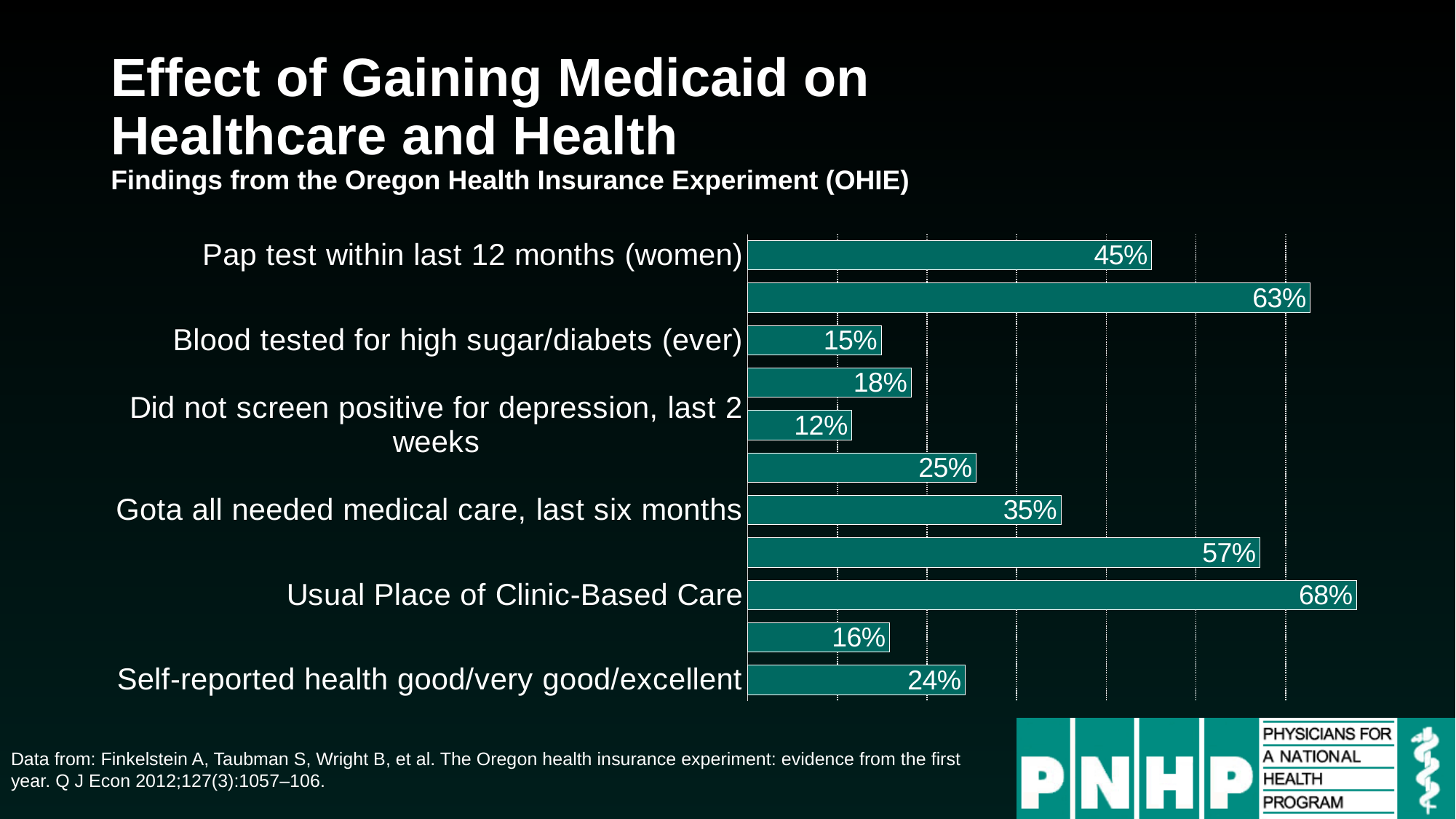
Which is larger, the value for "Gota all needed medical care, last six months" or the value for "Self-reported health good/very good/excellent"? Gota all needed medical care, last six months What is the value for "Blood tested for high sugar/diabets (ever)"? 15% What kind of chart is shown on the slide? Bar chart Which labeled category has the lowest value? Did not screen positive for depression, last 2 weeks What is the value for "Did not screen positive for depression, last 2 weeks"? 12% Which labeled category has the highest value? Usual Place of Clinic-Based Care What is the value for "Pap test within last 12 months (women)"? 45% What is the difference between the values for "Usual Place of Clinic-Based Care" and "Pap test within last 12 months (women)"? 23% What is the value for "Gota all needed medical care, last six months"? 35% What is the value for "Self-reported health good/very good/excellent"? 24% How many bars are plotted in the chart? 11 What is the value for "Usual Place of Clinic-Based Care"? 68%